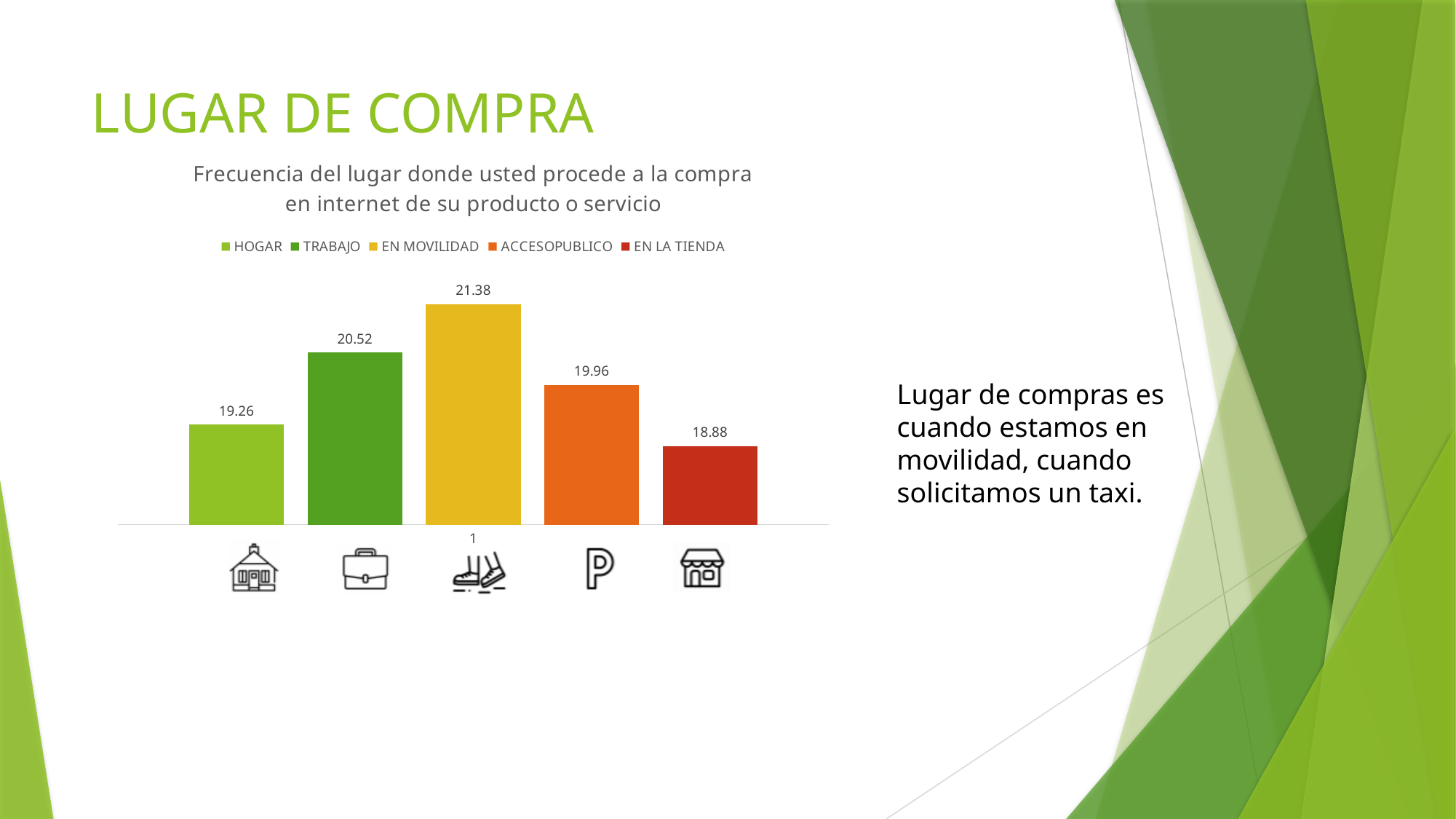
What is the value for EN LA TIENDA? 18.88 What kind of chart is shown on the slide? Bar chart What is the value for ACCESOPUBLICO? 19.96 What is the value for EN MOVILIDAD? 21.38 How many bars are shown in the chart? 5 Which category has the lowest value? EN LA TIENDA What is the value for HOGAR? 19.26 Which category has the highest value? EN MOVILIDAD What is the difference between the values for EN MOVILIDAD and EN LA TIENDA? 2.50 How many entries does the legend list? 5 What is the difference between the values for TRABAJO and HOGAR? 1.26 Which is larger, the value for TRABAJO or the value for ACCESOPUBLICO? TRABAJO